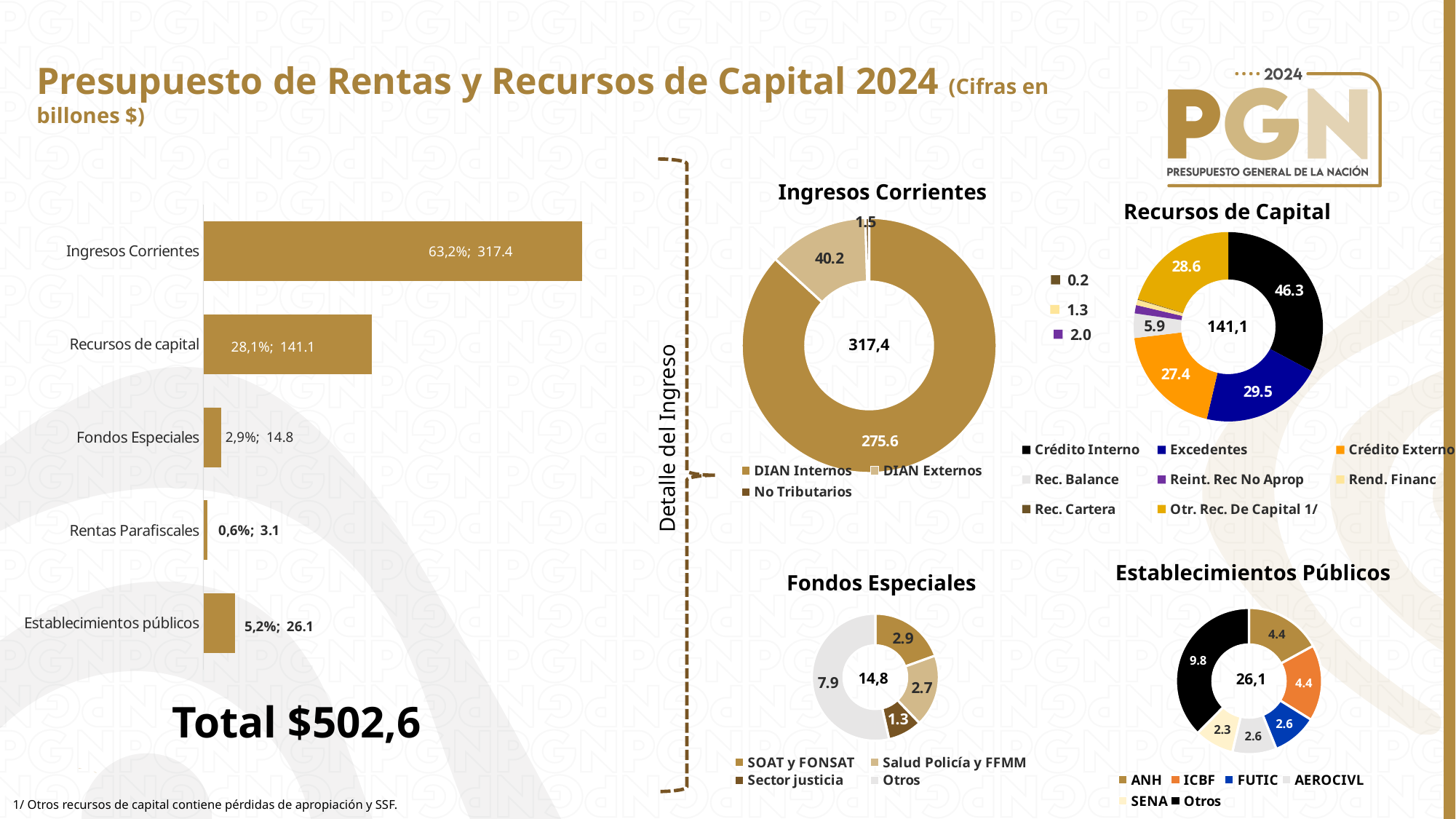
In the bar chart on the left, which category has the lowest value? Rentas Parafiscales In the Fondos Especiales donut chart, which is larger, SOAT y FONSAT or Sector justicia? SOAT y FONSAT In the bar chart on the left, how many categories are shown? 5 In the bar chart on the left, what value is shown for Ingresos Corrientes? 317.4 In the bar chart on the left, what percentage is shown for Recursos de capital? 28,1% In the Recursos de Capital donut chart, how many entries does the legend list? 8 In the Ingresos Corrientes donut chart, which segment is the largest? DIAN Internos In the Ingresos Corrientes donut chart, what value is shown for DIAN Externos? 40.2 In the Establecimientos Públicos donut chart, what value is shown for SENA? 2.3 In the bar chart on the left, what is the difference between the values for Establecimientos públicos and Fondos Especiales? 11.3 What type of chart is used on the left side of the slide? Bar chart In the Recursos de Capital donut chart, what value is shown for Excedentes? 29.5